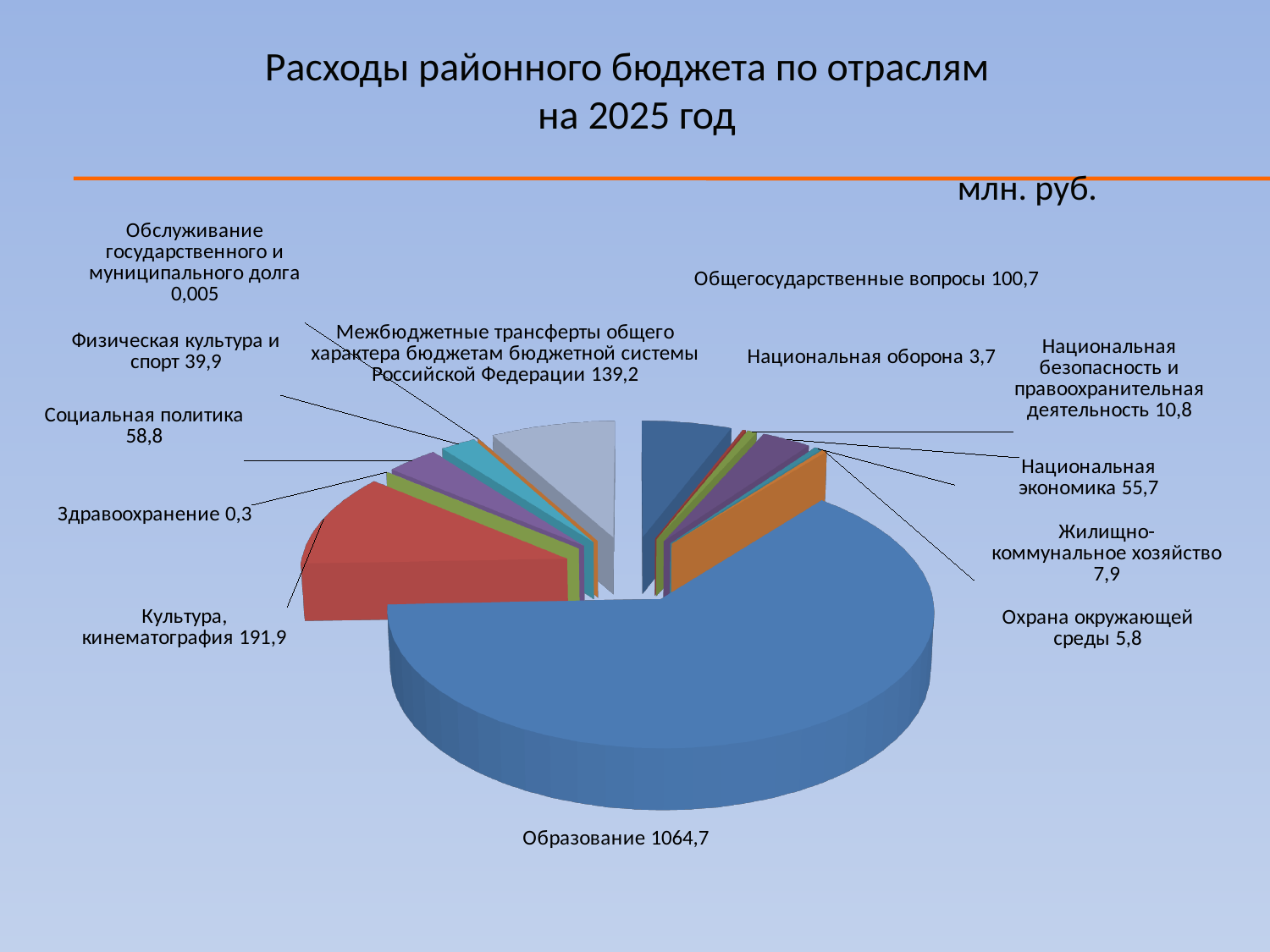
Which is larger: Общегосударственные вопросы or Национальная экономика? Общегосударственные вопросы Which category has the largest share of the pie? Образование What is the difference between Культура, кинематография and Межбюджетные трансферты общего характера бюджетам бюджетной системы Российской Федерации? 52,7 What is the value for Культура, кинематография? 191,9 What is the value for Образование? 1064,7 What is the difference between Социальная политика and Физическая культура и спорт? 18,9 Which category has the smallest value? Обслуживание государственного и муниципального долга What is the value for Национальная экономика? 55,7 What type of chart is shown on the slide? Pie chart In what units are the values on the chart expressed? млн. руб. What is the value for Обслуживание государственного и муниципального долга? 0,005 How many categories are shown in the pie chart? 13